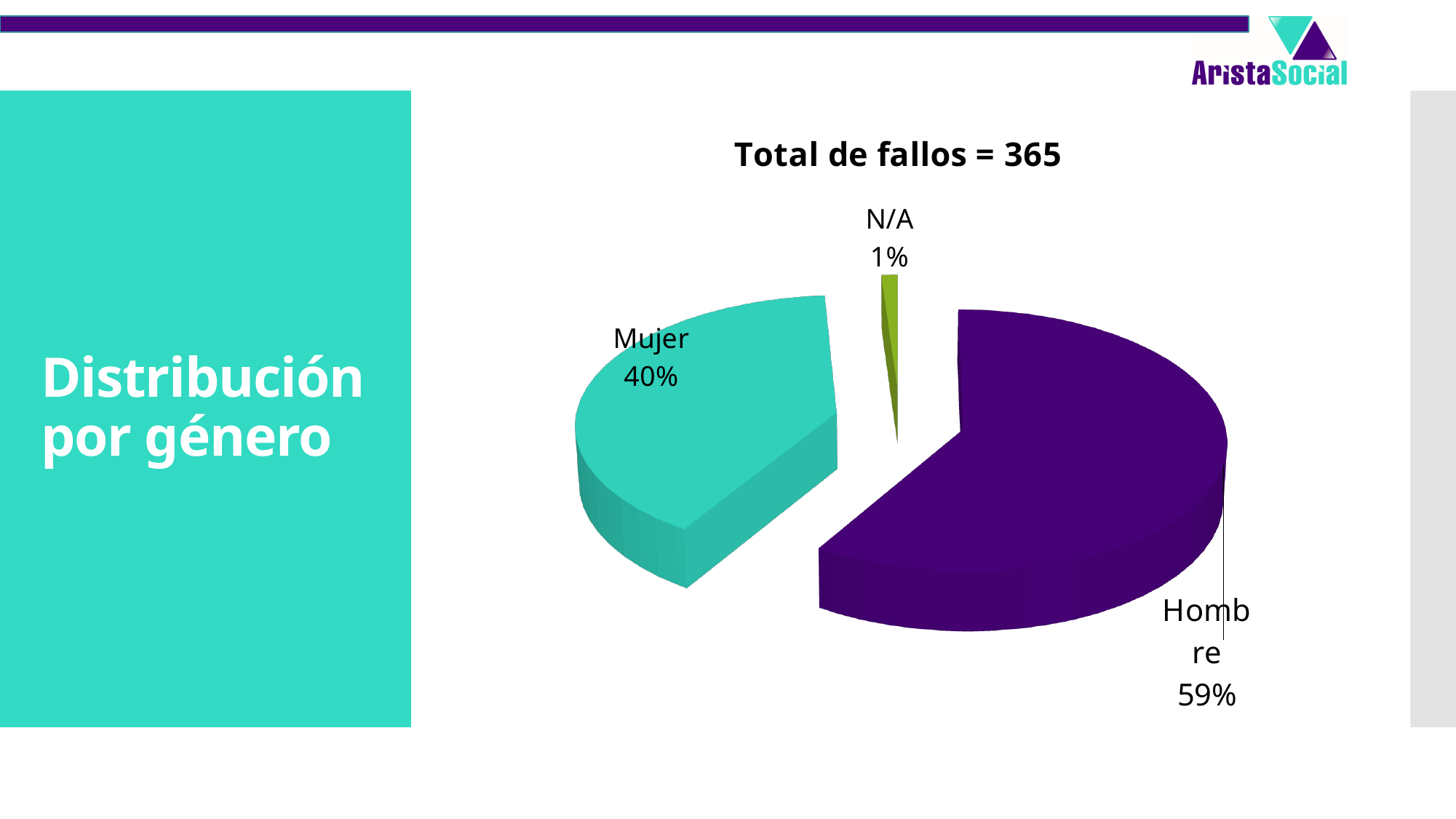
What share of the pie does Mujer represent? 40% What is the total number of fallos stated in the chart title? 365 What is the difference in percentage points between Hombre and Mujer? 19 What kind of chart is shown on the slide? pie chart Which is larger, the share for Mujer or the share for Hombre? Hombre Which category has the largest slice of the pie? Hombre What is the title of the chart? Total de fallos = 365 What share of the pie does N/A represent? 1% How many slices does the pie chart have? 3 What share of the pie does Hombre represent? 59% Which category has the smallest slice of the pie? N/A What colour is the Hombre slice? purple